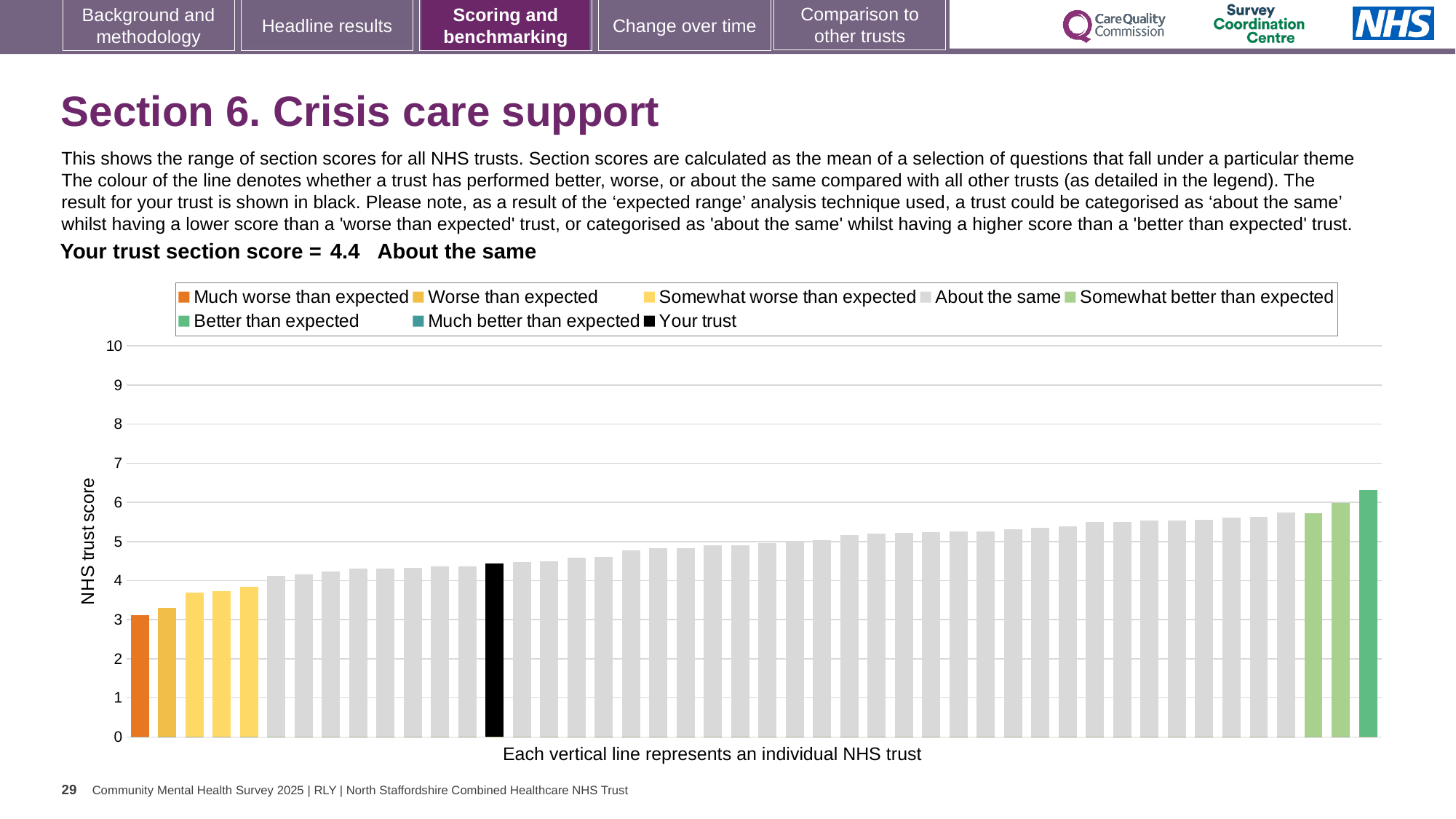
Is the value of the highest bar greater or less than 6? greater Do the bar values rise or fall from left to right across the chart? rise How many bars are coloured as 'Somewhat worse than expected'? 3 What kind of chart is used to show the NHS trust scores? bar chart How many bars are coloured as 'Somewhat better than expected'? 2 How many entries does the chart legend list? 8 How many bars are coloured as 'Much worse than expected'? 1 Is the value of the lowest bar greater or less than 4? less Which category is your trust placed in for this section? About the same What is the label on the vertical axis of the chart? NHS trust score What is the section score for your trust shown on the slide? 4.4 Is the value for your trust (the black bar) greater or less than 5? less